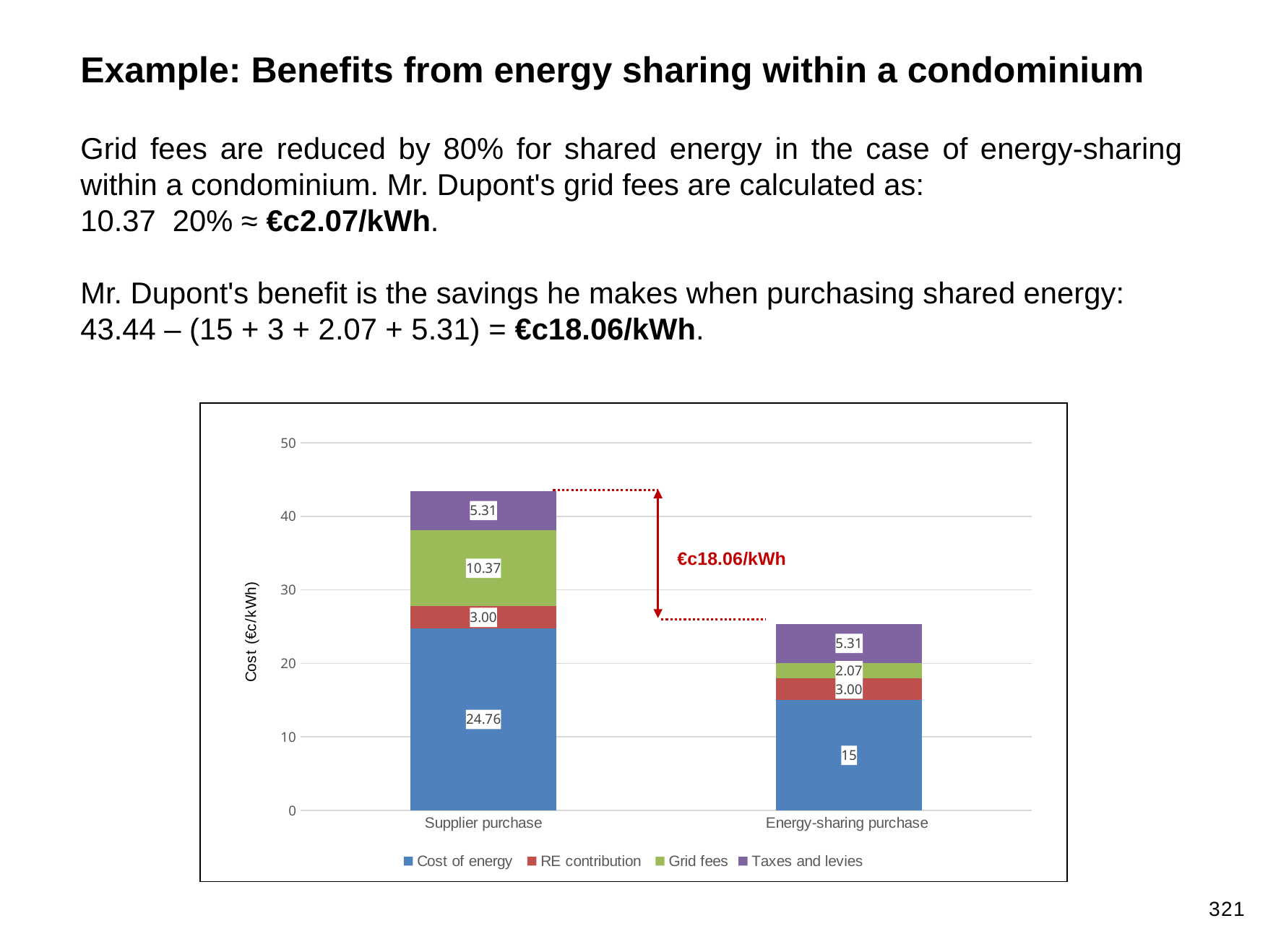
What is the label of the y axis of the chart? Cost (€c/kWh) Is the total for Supplier purchase greater or less than 40? greater How many categories are shown on the x axis of the chart? 2 What is the difference in Grid fees between Supplier purchase and Energy-sharing purchase? 8.30 What is the Grid fees value for Energy-sharing purchase? 2.07 What is the Cost of energy value for Supplier purchase? 24.76 How many series does the chart legend list? 4 What type of chart is shown on the slide? Stacked bar chart Which category has the higher total stacked bar, Supplier purchase or Energy-sharing purchase? Supplier purchase What is the Cost of energy value for Energy-sharing purchase? 15 What is the Taxes and levies value for Supplier purchase? 5.31 What is the total of the stacked bar for Energy-sharing purchase? 25.38